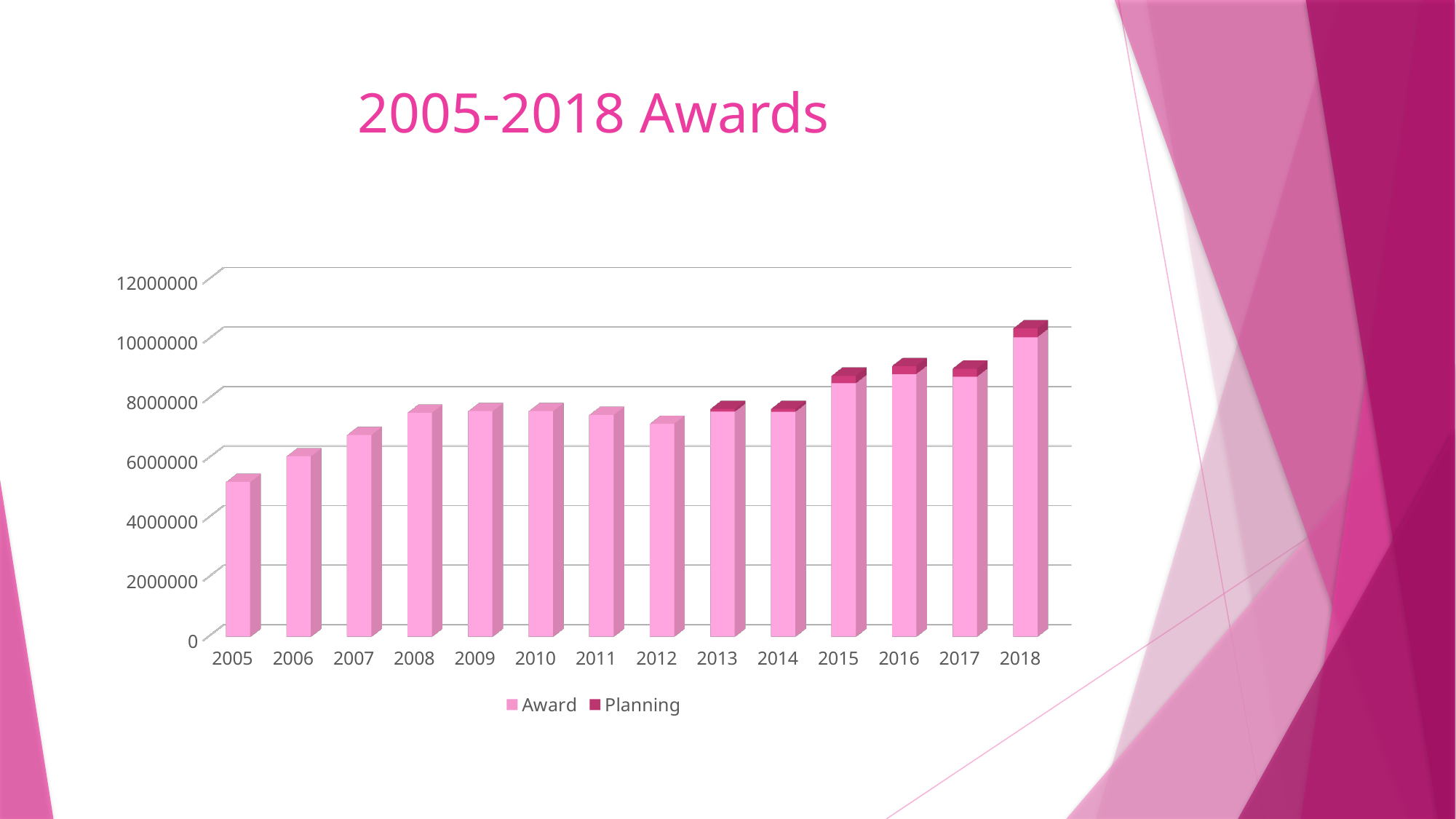
Is the total value for 2015 greater or less than 8000000? greater Which year has the highest total bar? 2018 Which year has the lowest total bar? 2005 Is the value for 2005 greater or less than 6000000? less How many years are shown on the x axis of the chart? 14 Do the bar values generally rise or fall from 2005 to 2018? rise Which is larger, the total bar for 2018 or the bar for 2005? 2018 What is the title of the slide? 2005-2018 Awards Is the value for 2012 greater or less than 8000000? less What kind of chart is shown on the slide? bar chart How many series does the legend list? 2